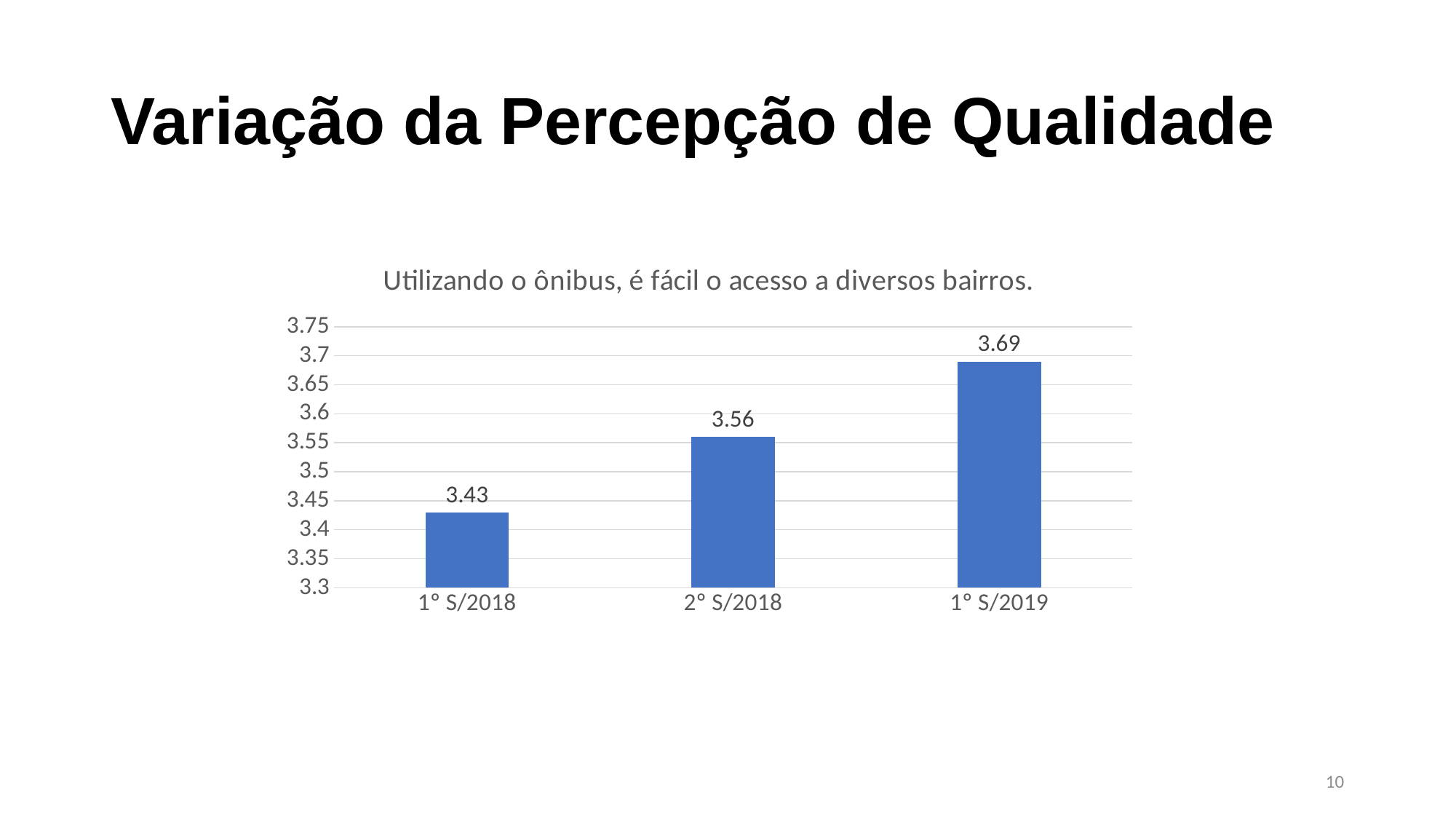
Which period has the highest value? 1° S/2019 Do the values rise or fall from 1° S/2018 to 1° S/2019? rise What is the difference between the values for 1° S/2019 and 1° S/2018? 0.26 How many periods are shown on the x axis? 3 Is the value for 2° S/2018 greater or less than 3.5? greater What is the value for 1° S/2018? 3.43 Which period has the lowest value? 1° S/2018 Which is larger, the value for 2° S/2018 or the value for 1° S/2019? 1° S/2019 What kind of chart is shown on the slide? bar chart What is the value for 2° S/2018? 3.56 What is the difference between the values for 2° S/2018 and 1° S/2018? 0.13 What is the value for 1° S/2019? 3.69